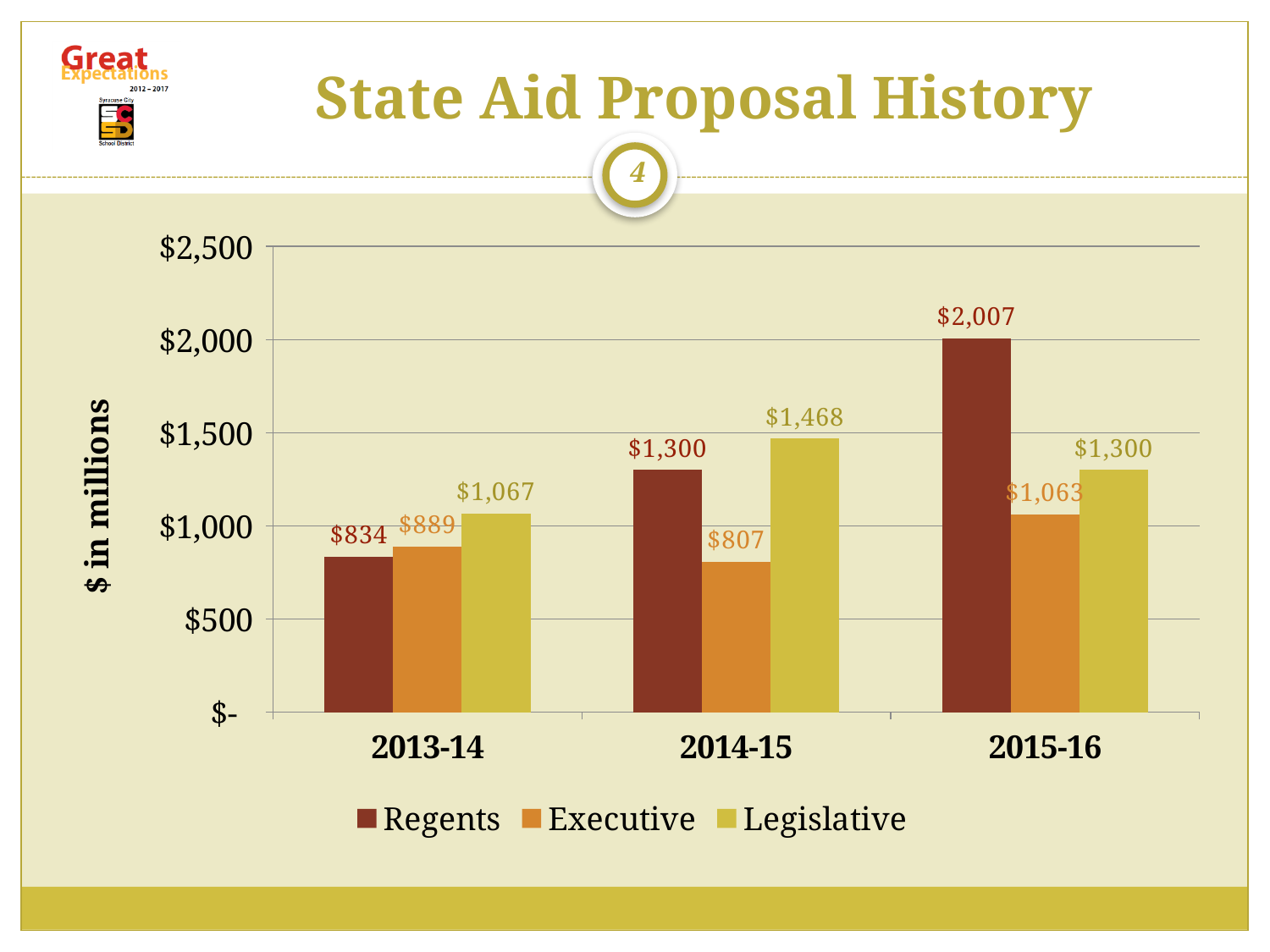
How many series does the legend list? 3 What is the difference between the Legislative and Executive values for 2014-15? $661 What kind of chart is shown on the slide? bar chart Which is larger in 2013-14, the Regents value or the Legislative value? Legislative Which year has the lowest Executive value? 2014-15 What is the Executive value for 2014-15? $807 Is the Regents value for 2015-16 greater or less than $2,000? greater What is the Legislative value for 2013-14? $1,067 How many years are shown on the x axis? 3 Which year has the highest Regents value? 2015-16 What is the Regents value for 2015-16? $2,007 Does the Regents value rise or fall from 2013-14 to 2015-16? rise